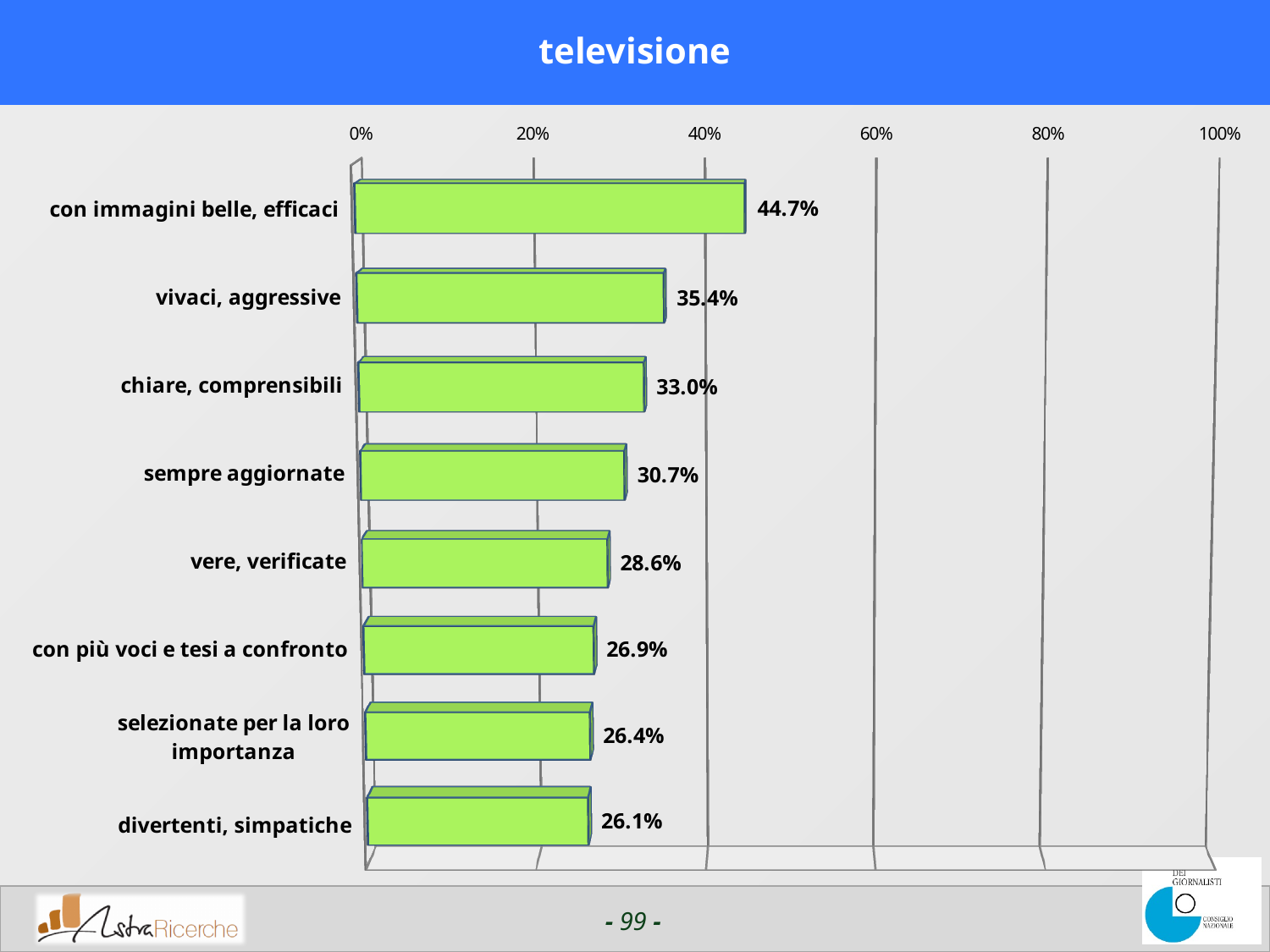
Which is larger: the value for "vere, verificate" or the value for "con più voci e tesi a confronto"? vere, verificate Which category has the lowest value? divertenti, simpatiche What is the difference between the values for "vivaci, aggressive" and "chiare, comprensibili"? 2.4% Which category has the highest value? con immagini belle, efficaci What is the title of the chart? televisione What is the value for "con immagini belle, efficaci"? 44.7% What kind of chart is shown on the slide? bar chart How many categories are shown in the chart? 8 What is the value for "sempre aggiornate"? 30.7% What is the value for "divertenti, simpatiche"? 26.1% Is the value for "selezionate per la loro importanza" greater or less than 40%? less Is the value for "con immagini belle, efficaci" greater or less than 40%? greater